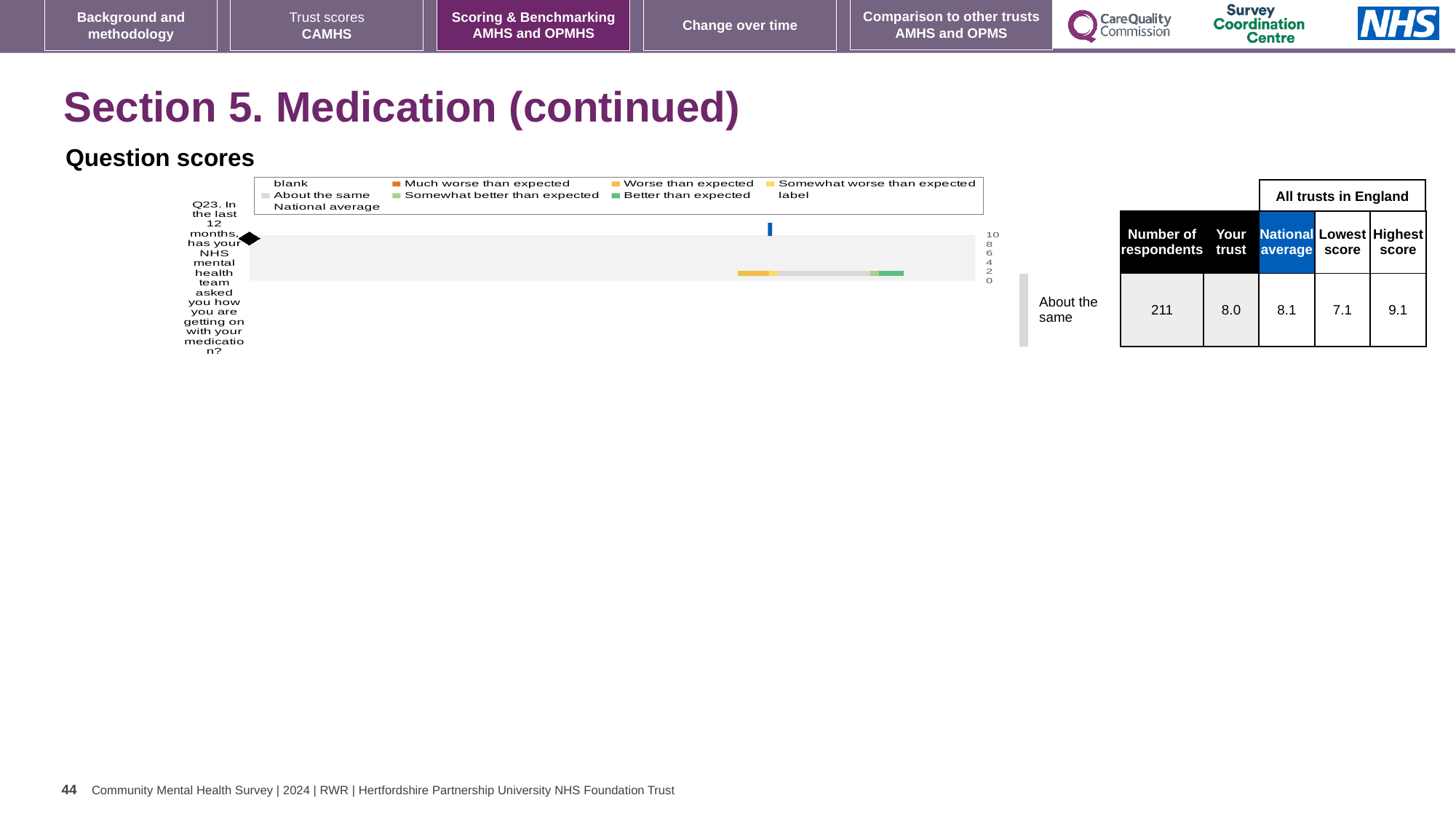
In the table beside the chart, what is the highest score among all trusts in England for Q23? 9.1 In the table beside the chart, what is the 'Your trust' score for Q23? 8.0 In the table beside the chart, what is the number of respondents for Q23? 211 What benchmark category is shown for Q23 to the right of the chart? About the same In the table beside the chart, what is the national average score for Q23? 8.1 For Q23, what is the difference between the highest score and the lowest score among all trusts in England? 2.0 For Q23, which is larger: the 'Your trust' score or the national average? National average What is the highest tick value shown on the chart's score axis? 10 Which survey question does the chart show? Q23. In the last 12 months, has your NHS mental health team asked you how you are getting on with your medication? In the table beside the chart, what is the lowest score among all trusts in England for Q23? 7.1 How many survey questions (categories) are plotted in the chart? 1 What kind of chart is shown on the slide? bar chart